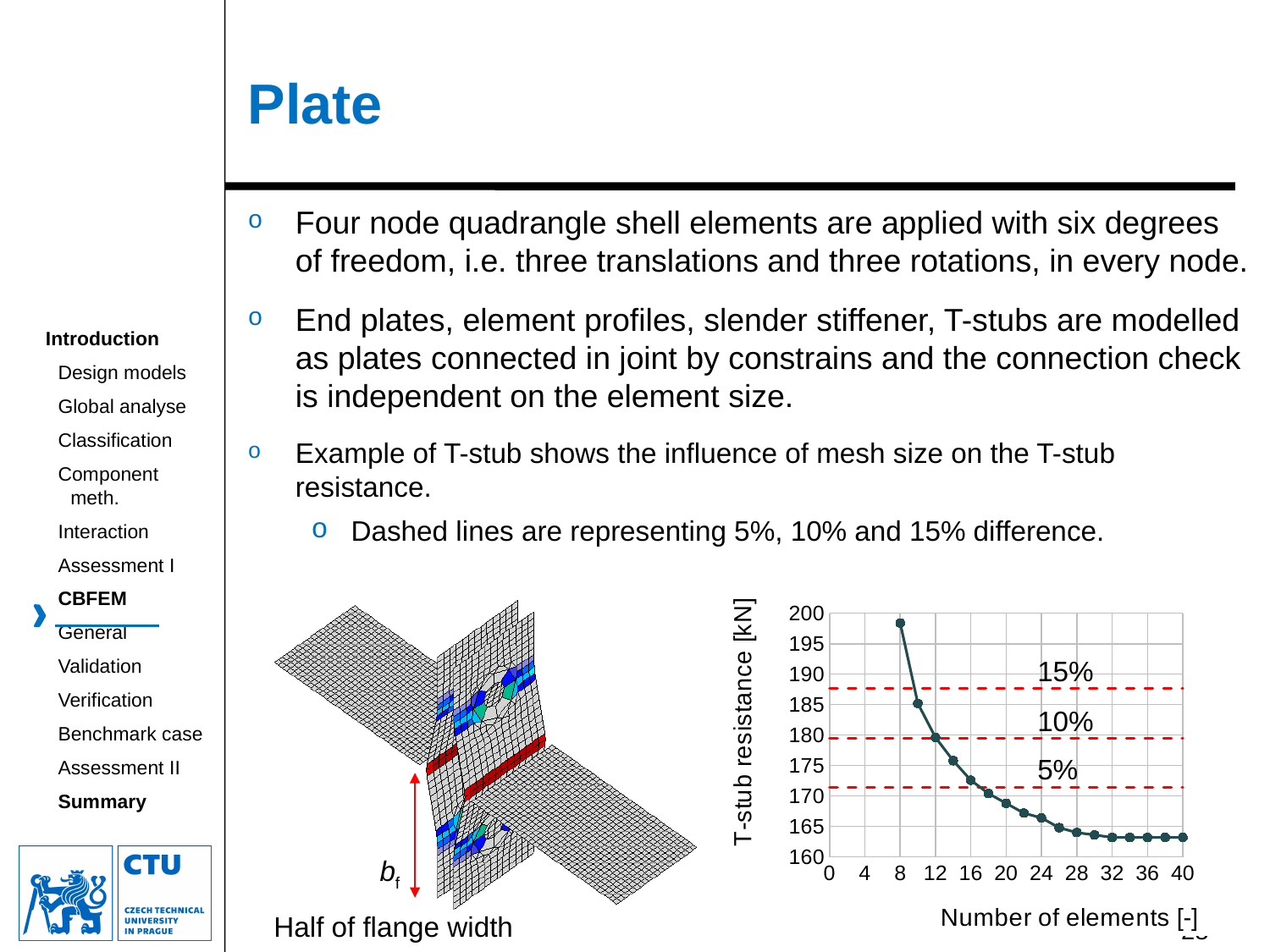
What kind of chart is shown on the slide? line chart Is the T-stub resistance at 10 elements greater or less than 180 kN? greater Is the T-stub resistance at 24 elements greater or less than 170 kN? less Is the T-stub resistance at 16 elements greater or less than 170 kN? greater Which has the larger T-stub resistance: 12 elements or 20 elements? 12 elements Does the T-stub resistance rise or fall as the number of elements increases? fall What is the title of the x axis of the chart? Number of elements [-] What is the title of the y axis of the chart? T-stub resistance [kN] At which number of elements is the T-stub resistance highest? 8 How many dashed difference lines are drawn on the chart? 3